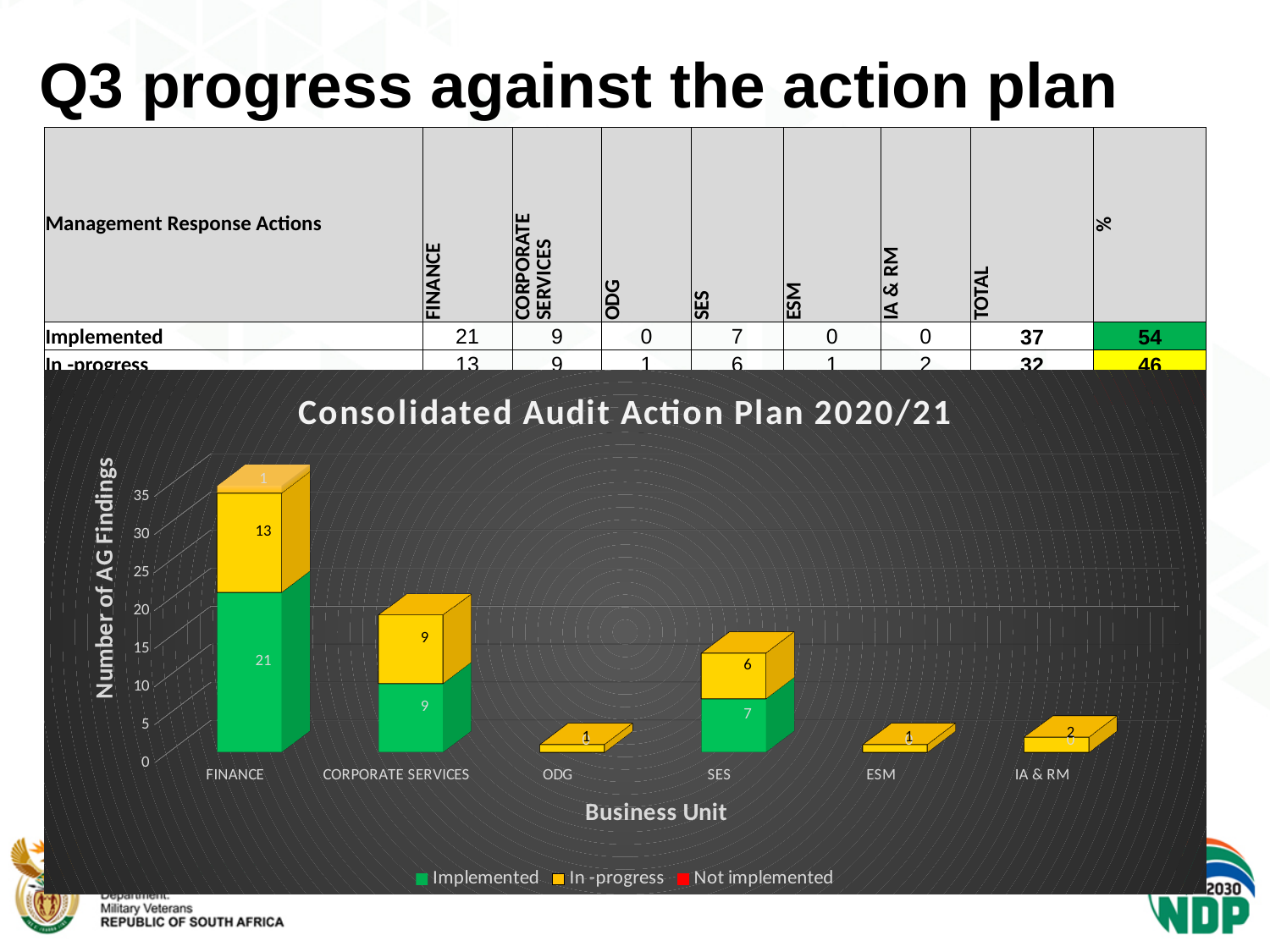
What is the total of the stacked bar for SES in the chart? 13 What is the In-progress value for FINANCE in the chart? 13 How many series does the chart legend list? 3 What type of chart is shown on the slide? stacked bar chart What is the In-progress value for SES in the chart? 6 What is the Implemented value for FINANCE in the chart? 21 Which business unit has the tallest stacked bar in the chart? FINANCE What is the difference between the Implemented values for FINANCE and SES in the chart? 14 What is the title of the chart? Consolidated Audit Action Plan 2020/21 Which has a larger Implemented value in the chart, CORPORATE SERVICES or SES? CORPORATE SERVICES How many business units are shown on the x axis of the chart? 6 What is the Implemented value for CORPORATE SERVICES in the chart? 9